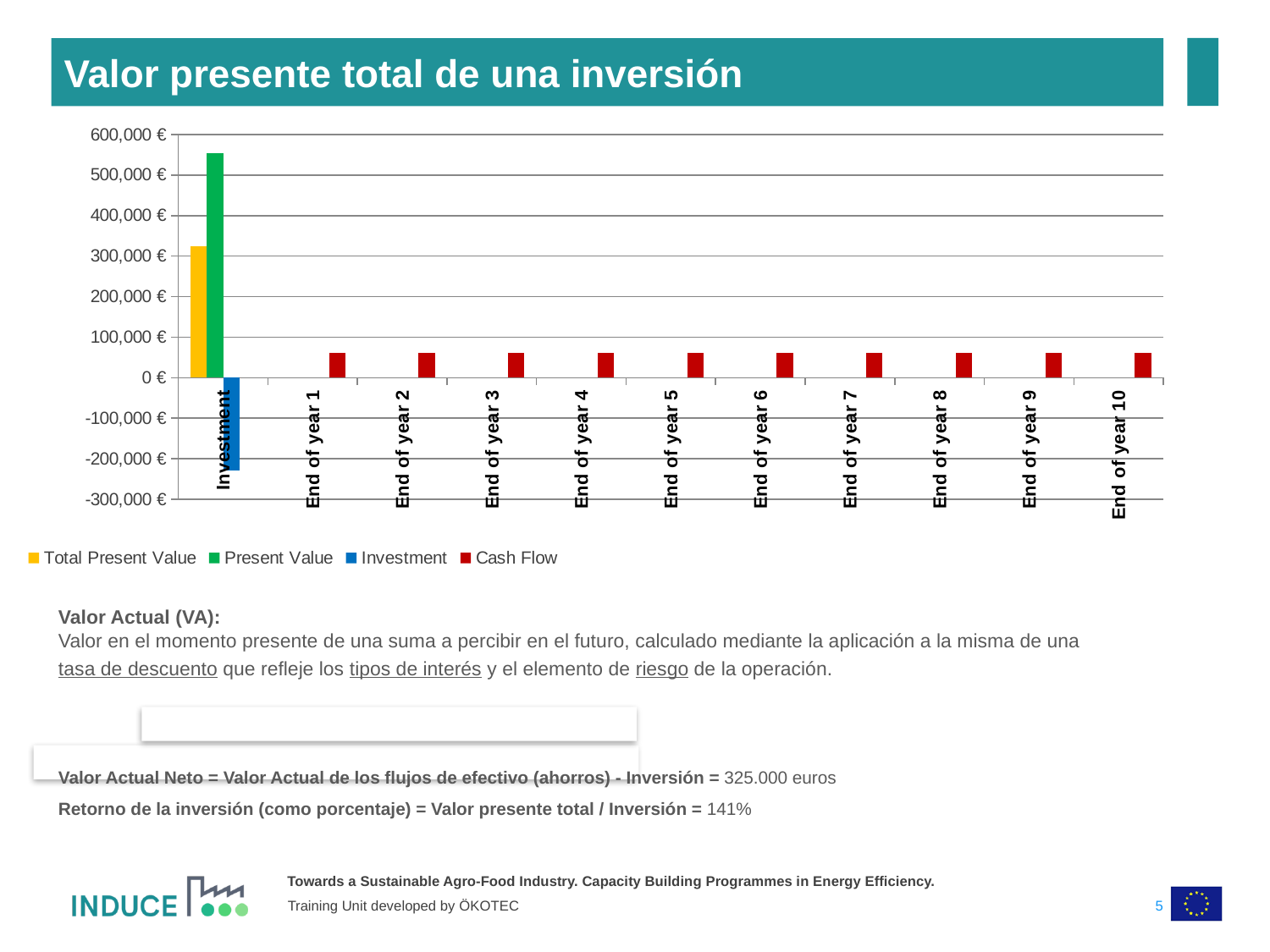
Is the Cash Flow value at End of year 5 greater or less than 100,000 €? less Which is larger, the Present Value bar or the Total Present Value bar? Present Value What kind of chart is shown on the slide? bar chart Is the value of the Total Present Value bar greater or less than 200,000 €? greater Which series has the tallest bar in the chart? Present Value Which series has the lowest (most negative) bar in the chart? Investment What colour represents the Cash Flow series in the chart legend? red Is the value of the Investment bar greater or less than -100,000 €? less How many categories are shown along the x axis of the chart? 11 Do the Cash Flow bars rise, fall or stay constant from End of year 1 to End of year 10? stay constant How many series does the chart legend list? 4